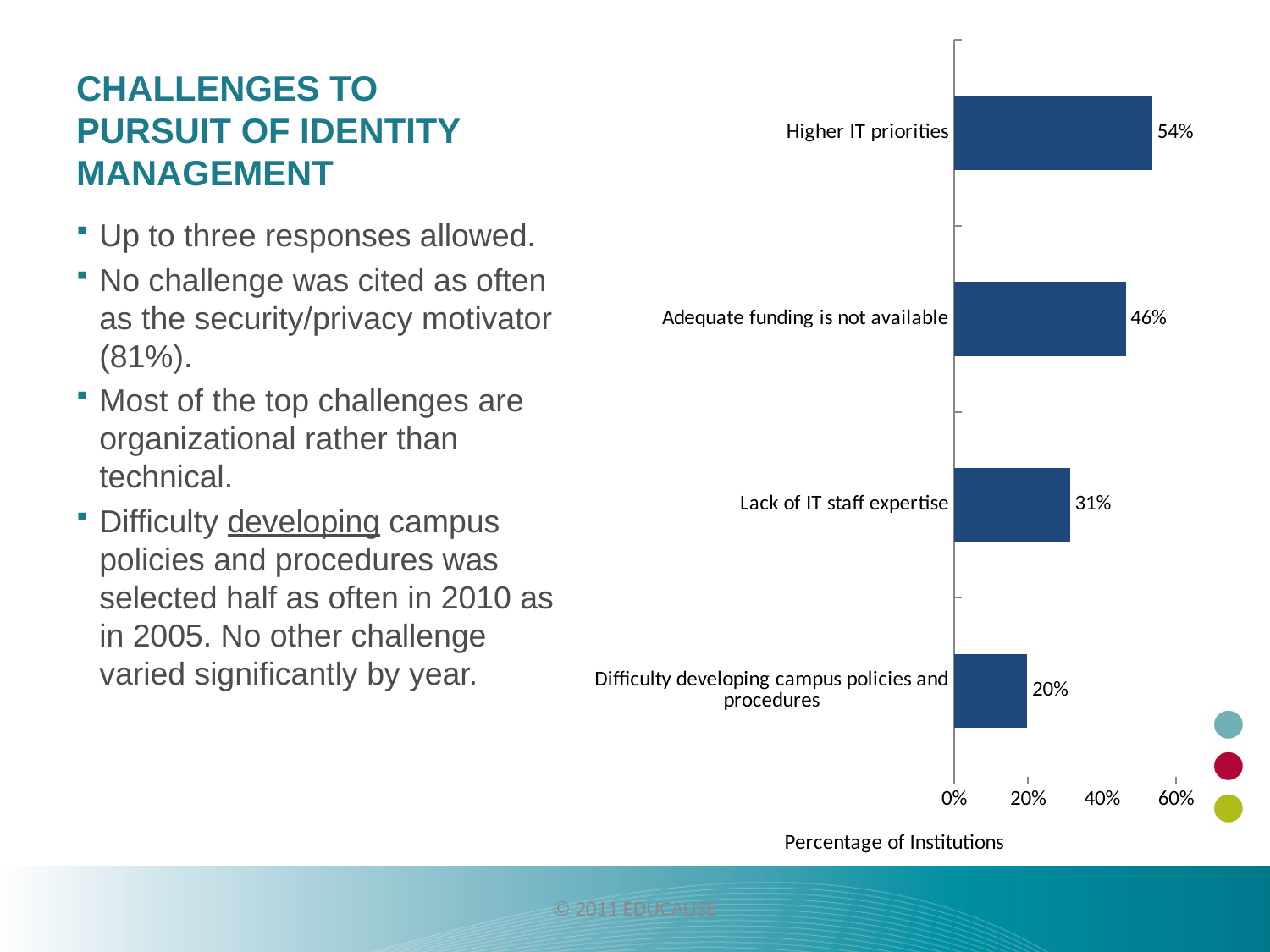
What is the value for Difficulty developing campus policies and procedures? 20% What is the value for Lack of IT staff expertise? 31% What percentage of institutions cited Higher IT priorities as a challenge? 54% How many challenges are shown in the chart? 4 What is the difference between the values for Higher IT priorities and Adequate funding is not available? 8% What is the difference between the values for Lack of IT staff expertise and Difficulty developing campus policies and procedures? 11% Which challenge has the lowest percentage of institutions? Difficulty developing campus policies and procedures Which is larger, the value for Adequate funding is not available or the value for Lack of IT staff expertise? Adequate funding is not available What is the value for Adequate funding is not available? 46% What kind of chart is shown on the slide? Bar chart What is the label of the horizontal axis of the chart? Percentage of Institutions Which challenge has the highest percentage of institutions? Higher IT priorities